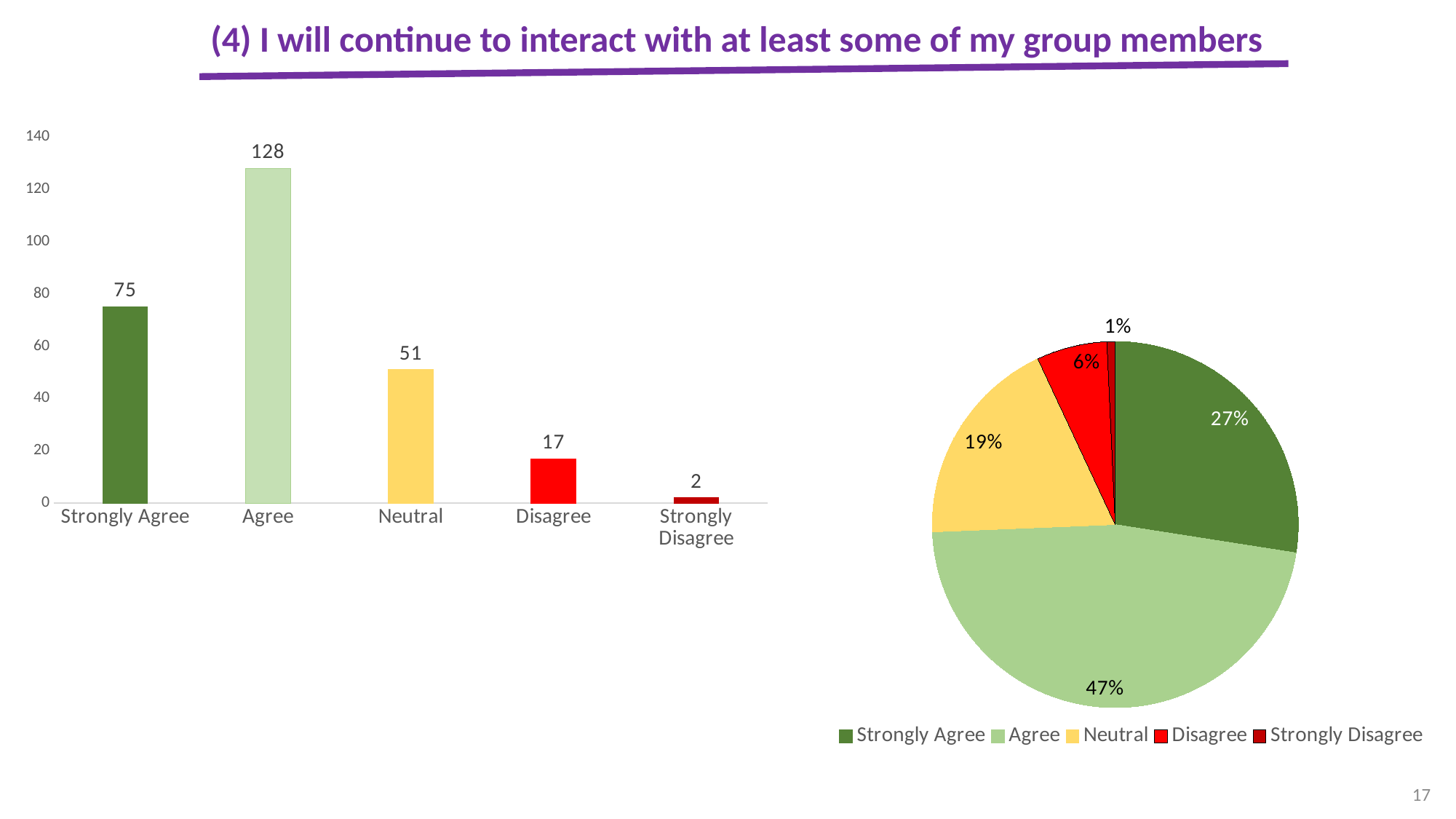
In the pie chart on the right, what share does Neutral have? 19% In the bar chart on the left, what is the value for Strongly Agree? 75 What kind of chart is on the left of the slide? Bar chart In the bar chart on the left, what is the value for Strongly Disagree? 2 In the bar chart on the left, what is the value for Agree? 128 In the bar chart on the left, how many categories are shown? 5 In the pie chart on the right, what share does Agree have? 47% In the bar chart on the left, which category has the highest value? Agree In the bar chart on the left, what is the difference between the values for Agree and Strongly Agree? 53 In the bar chart on the left, which is larger, the value for Neutral or the value for Disagree? Neutral In the bar chart on the left, which category has the lowest value? Strongly Disagree How many entries does the legend of the pie chart on the right list? 5